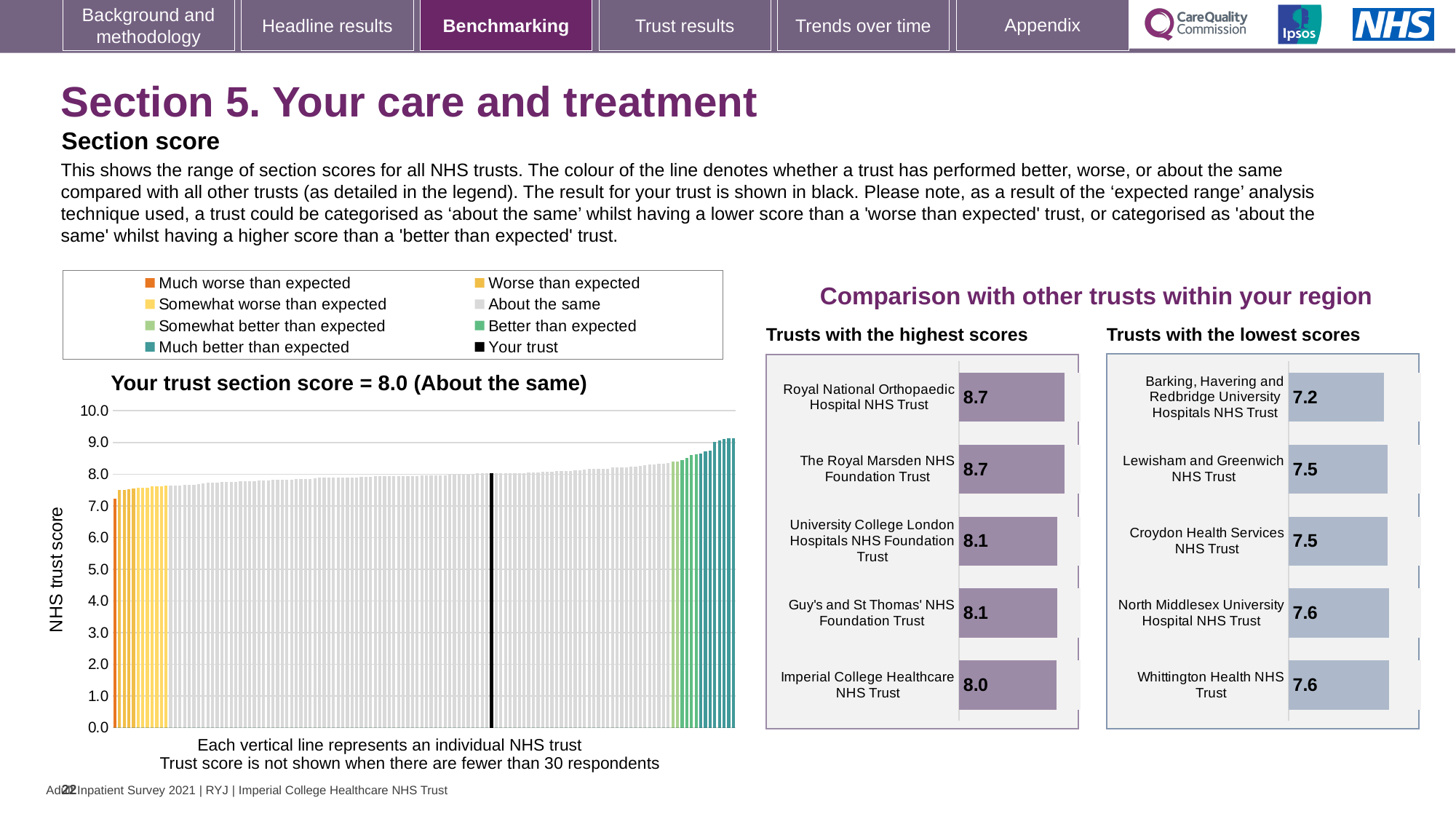
In the 'Trusts with the lowest scores' chart, what is the score for Barking, Havering and Redbridge University Hospitals NHS Trust? 7.2 In the 'Trusts with the highest scores' chart, what is the score for Imperial College Healthcare NHS Trust? 8.0 In the 'Trusts with the highest scores' chart, which trust has the lowest score? Imperial College Healthcare NHS Trust How many entries does the legend above the 'Your trust section score' chart list? 8 In the 'Trusts with the lowest scores' chart, which has the larger score: Barking, Havering and Redbridge University Hospitals NHS Trust or North Middlesex University Hospital NHS Trust? North Middlesex University Hospital NHS Trust What kind of chart is the 'Your trust section score' chart? bar chart In the 'Trusts with the lowest scores' chart, which trust has the lowest score? Barking, Havering and Redbridge University Hospitals NHS Trust In the 'Trusts with the highest scores' chart, what is the difference between the score for The Royal Marsden NHS Foundation Trust and the score for Imperial College Healthcare NHS Trust? 0.7 What is the y-axis label of the 'Your trust section score' chart? NHS trust score In the 'Your trust section score' chart, do the bars rise or fall from left to right? rise In the 'Trusts with the highest scores' chart, how many trusts are shown? 5 In the 'Your trust section score' chart, what is the section score for your trust? 8.0